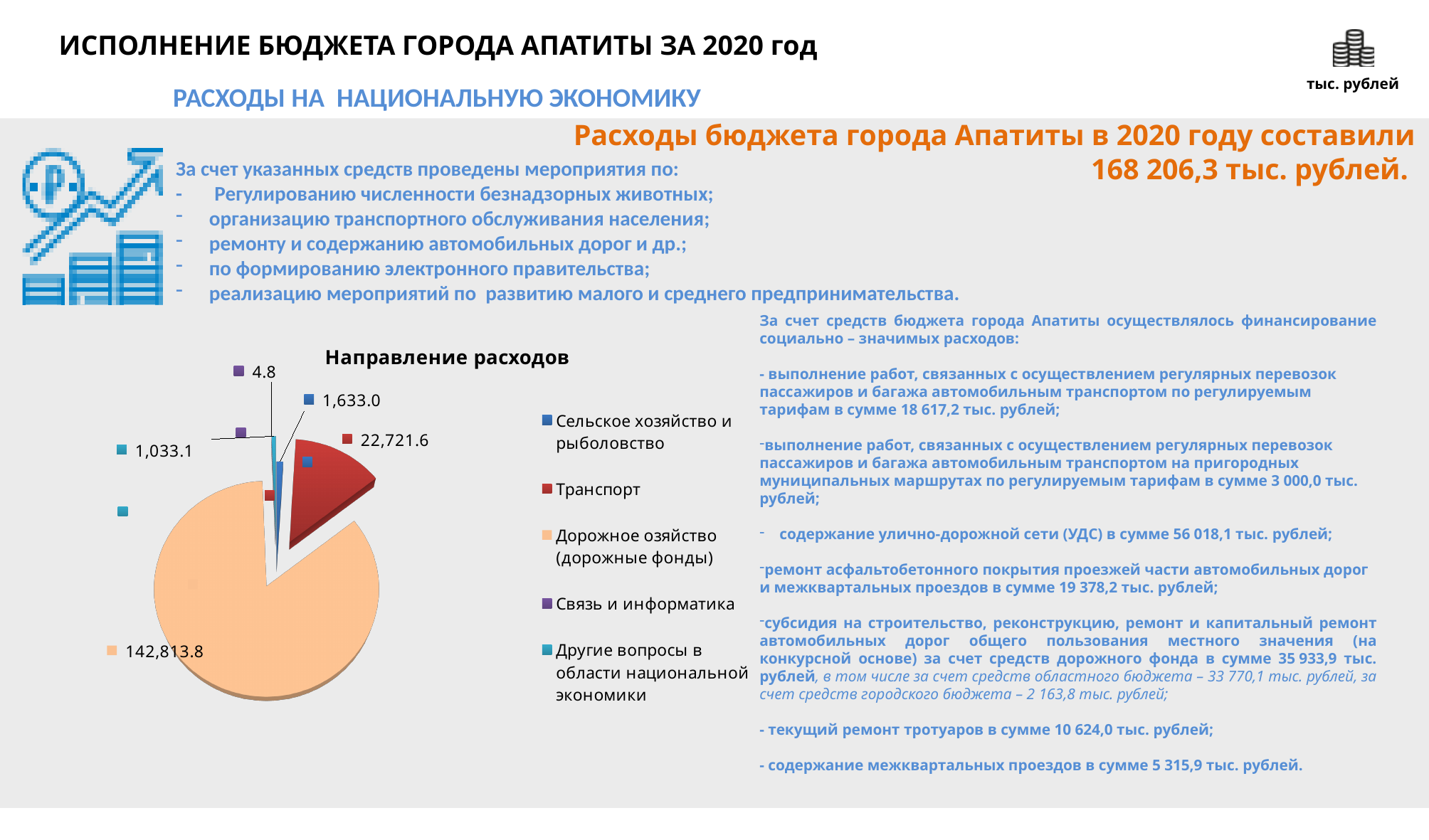
In the pie chart "Направление расходов", what is the difference between the values for Транспорт and Сельское хозяйство и рыболовство? 21,088.6 In the pie chart "Направление расходов", what is the value for Транспорт? 22,721.6 How many categories does the legend of the pie chart "Направление расходов" list? 5 In the pie chart "Направление расходов", what colour is the slice for Транспорт? red In the pie chart "Направление расходов", what is the value for Другие вопросы в области национальной экономики? 1,033.1 In the pie chart "Направление расходов", what is the value for Дорожное озяйство (дорожные фонды)? 142,813.8 In the pie chart "Направление расходов", what is the value for Связь и информатика? 4.8 What type of chart is shown under the title "Направление расходов"? pie chart In the pie chart "Направление расходов", what is the value for Сельское хозяйство и рыболовство? 1,633.0 Which category has the largest slice in the pie chart "Направление расходов"? Дорожное озяйство (дорожные фонды) Which category has the smallest value in the pie chart "Направление расходов"? Связь и информатика In the pie chart "Направление расходов", which is larger: Сельское хозяйство и рыболовство or Другие вопросы в области национальной экономики? Сельское хозяйство и рыболовство